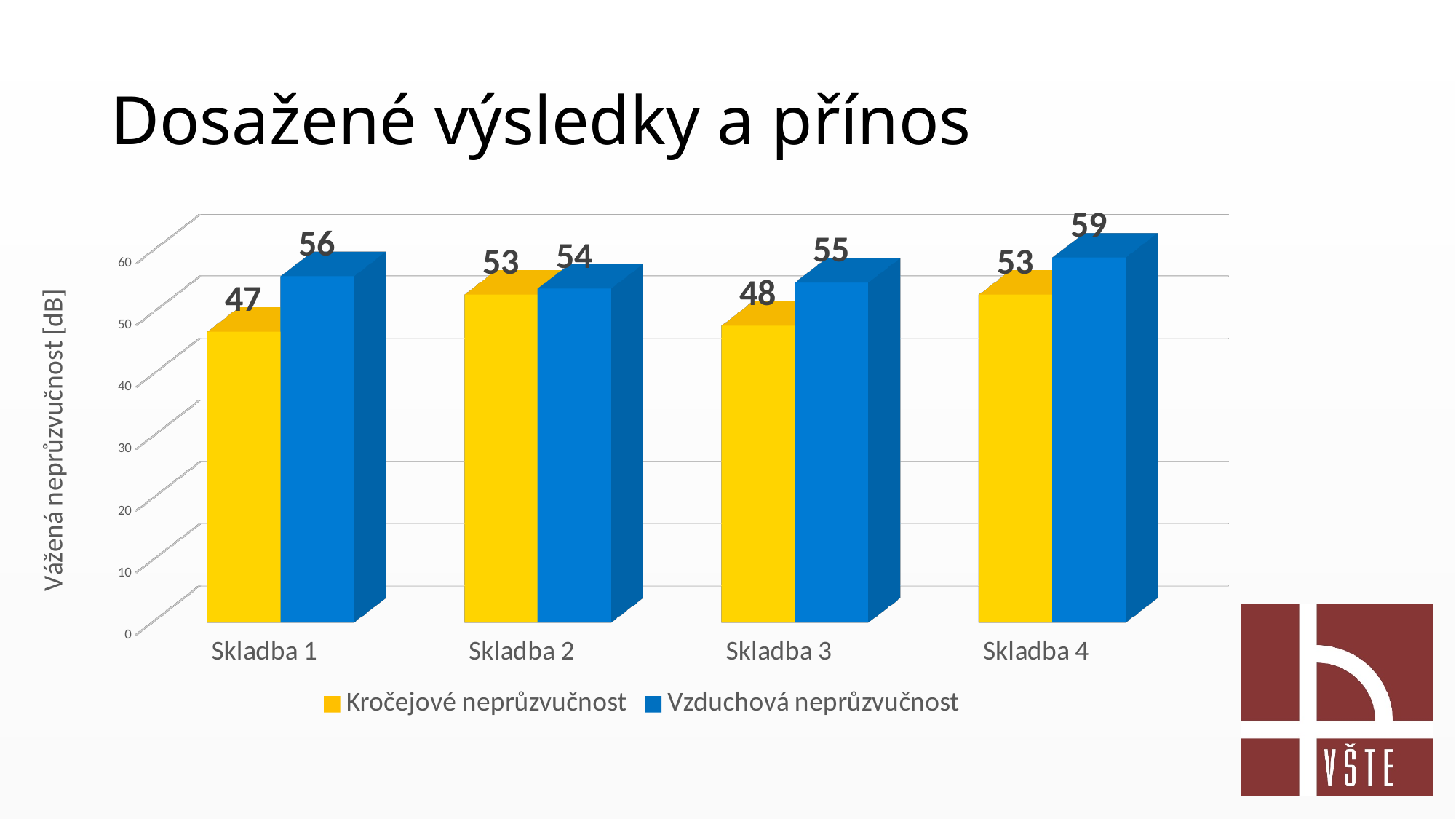
How many series does the legend list? 2 Is the Kročejové neprůzvučnost value for Skladba 2 greater or less than 50? greater Which category has the highest Vzduchová neprůzvučnost value? Skladba 4 What is the value of Vzduchová neprůzvučnost for Skladba 4? 59 What is the value of Kročejové neprůzvučnost for Skladba 1? 47 How many categories are shown on the x axis? 4 What is the label of the vertical axis? Vážená neprůzvučnost [dB] Which category has the lowest Kročejové neprůzvučnost value? Skladba 1 What kind of chart is shown on the slide? Bar chart What is the value of Vzduchová neprůzvučnost for Skladba 3? 55 Which is larger for Skladba 3: Kročejové neprůzvučnost or Vzduchová neprůzvučnost? Vzduchová neprůzvučnost What is the difference between Vzduchová neprůzvučnost and Kročejové neprůzvučnost for Skladba 1? 9